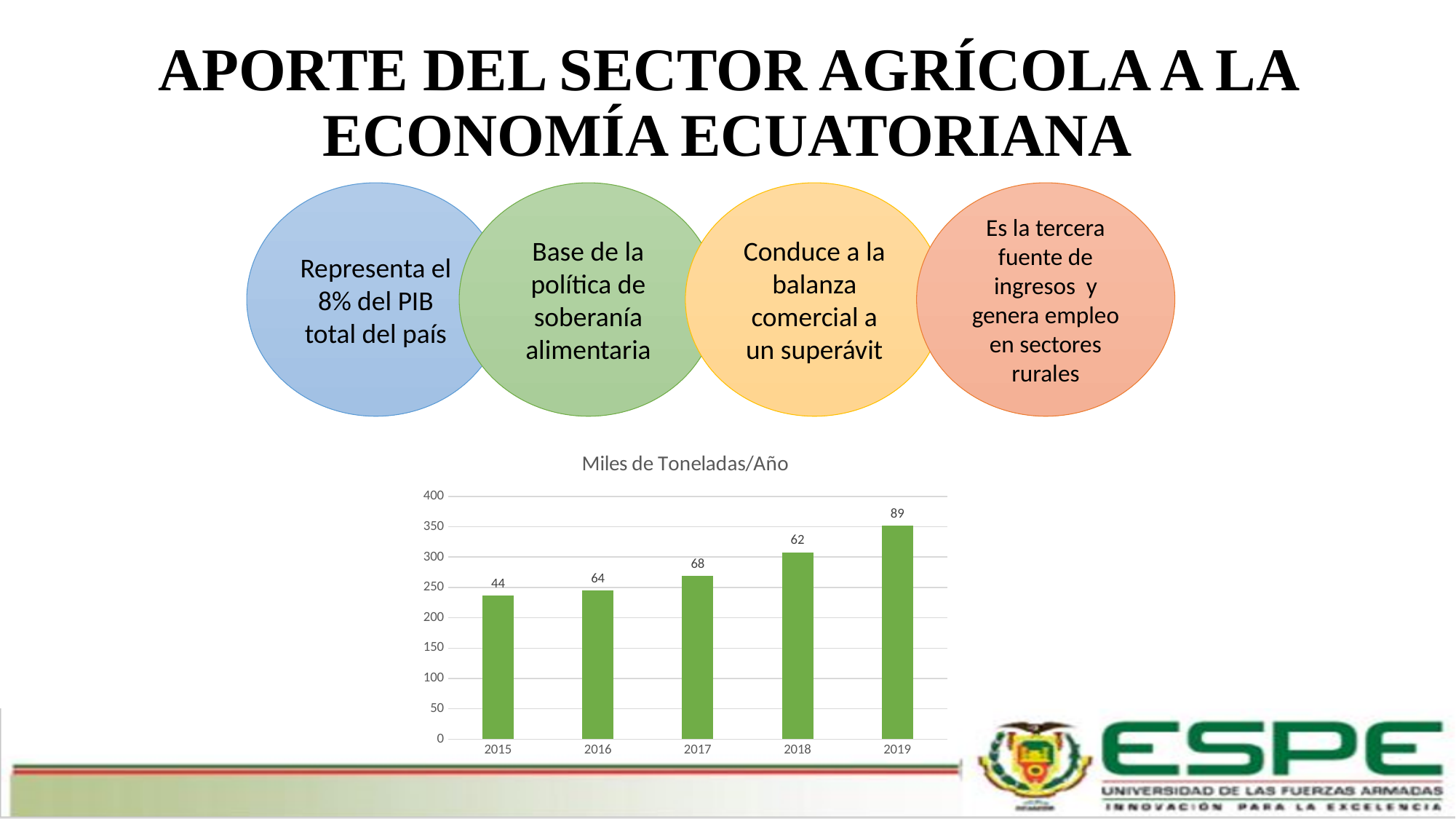
What is the value shown for 2015 in the chart? 44 What is the value shown for 2016 in the chart? 64 How many years are shown on the x axis of the chart? 5 What is the value shown for 2019 in the chart? 89 What is the value shown for 2018 in the chart? 62 Which year has the highest value in the chart? 2019 What kind of chart is shown on the slide? Bar chart What is the title of the chart? Miles de Toneladas/Año What colour are the bars in the chart? Green What is the difference between the values labelled for 2019 and 2015? 45 What is the value shown for 2017 in the chart? 68 Which year has the lowest value in the chart? 2015